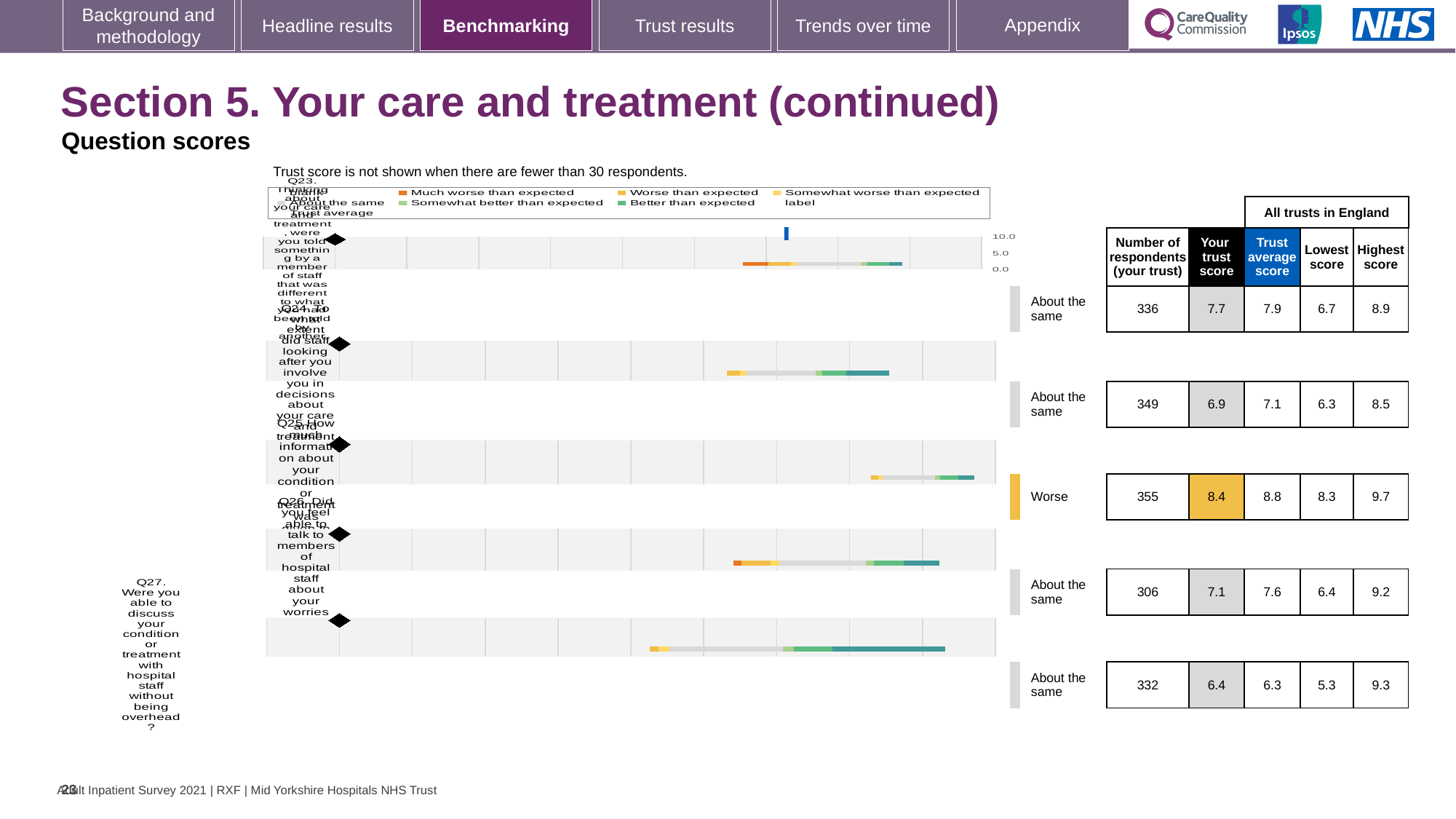
Is the number of respondents for Q24 larger or smaller than for Q27? larger What is the lowest score across all trusts in England for Q24? 6.3 What is the trust score for Q25 (how much information about your condition or treatment was given to you)? 8.4 What is the trust average score for Q27 (discussing your condition or treatment without being overheard)? 6.3 What is the highest score across all trusts in England for Q26? 9.2 What kind of chart is used to show the benchmarking results? bar chart What is the number of respondents for Q23 in the table? 336 What is the difference between the trust average score and your trust score for Q26? 0.5 Which question has the highest 'Your trust score' in the table? Q25 How many questions (Q23 to Q27) are shown on the chart? 5 Which question has the lowest 'Lowest score' value in the table? Q27 Which question is rated 'Worse' in the benchmarking category column? Q25